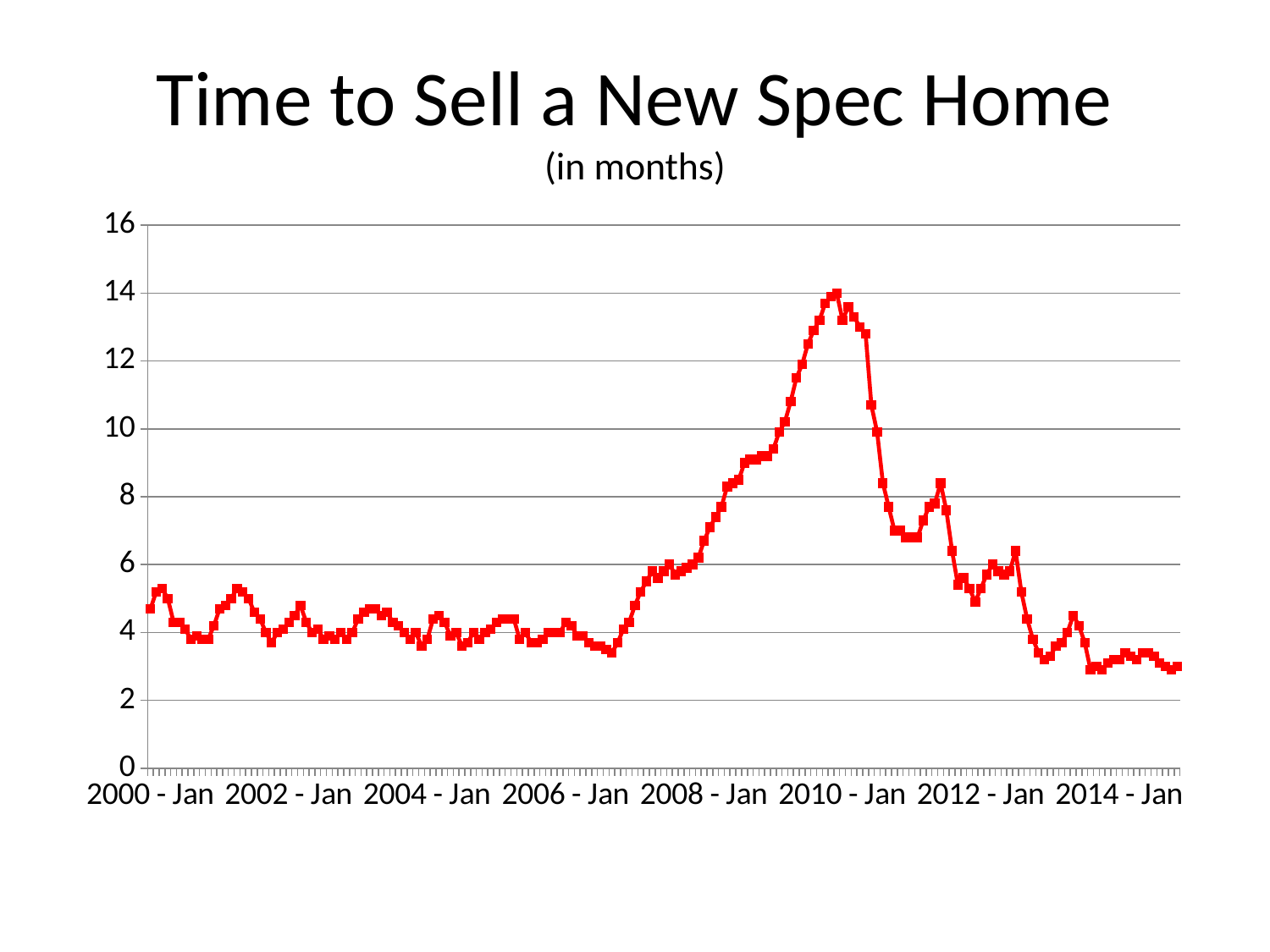
What kind of chart is shown on the slide? line chart What is the title of the chart? Time to Sell a New Spec Home In what unit are the values on the chart measured, according to the subtitle? months Is the value at 2014 - Jan greater or less than 4? less Is the value at 2012 - Jan greater or less than 10? less Is the value at 2010 - Jan greater or less than 12? greater Between 2006 - Jan and 2010 - Jan, does the line generally rise or fall? rise Between 2010 - Jan and 2014 - Jan, does the line generally rise or fall? fall Around which x-axis label does the line reach its highest point? 2010 - Jan Which is larger, the value at 2010 - Jan or the value at 2000 - Jan? 2010 - Jan